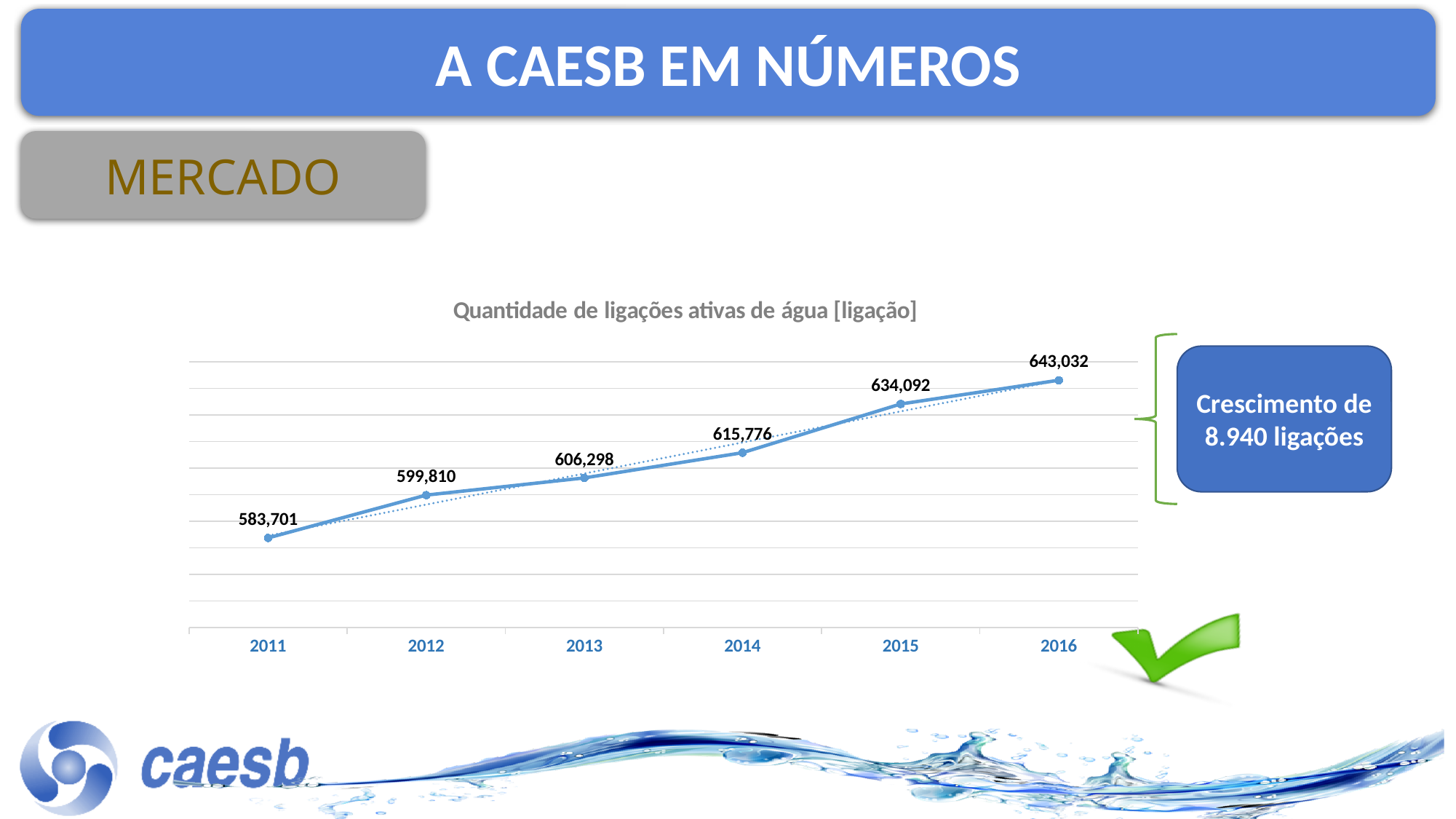
Which is larger, the value for 2013 or the value for 2015? 2015 What is the difference between the values for 2016 and 2015? 8,940 What is the value for 2016? 643,032 How many years are plotted on the x axis? 6 Which year has the lowest value? 2011 Which year has the highest value? 2016 What is the value for 2014? 615,776 What kind of chart is shown? line chart What is the value for 2011? 583,701 What is the value for 2013? 606,298 What is the difference between the values for 2012 and 2011? 16,109 Do the values rise or fall from 2011 to 2016? rise